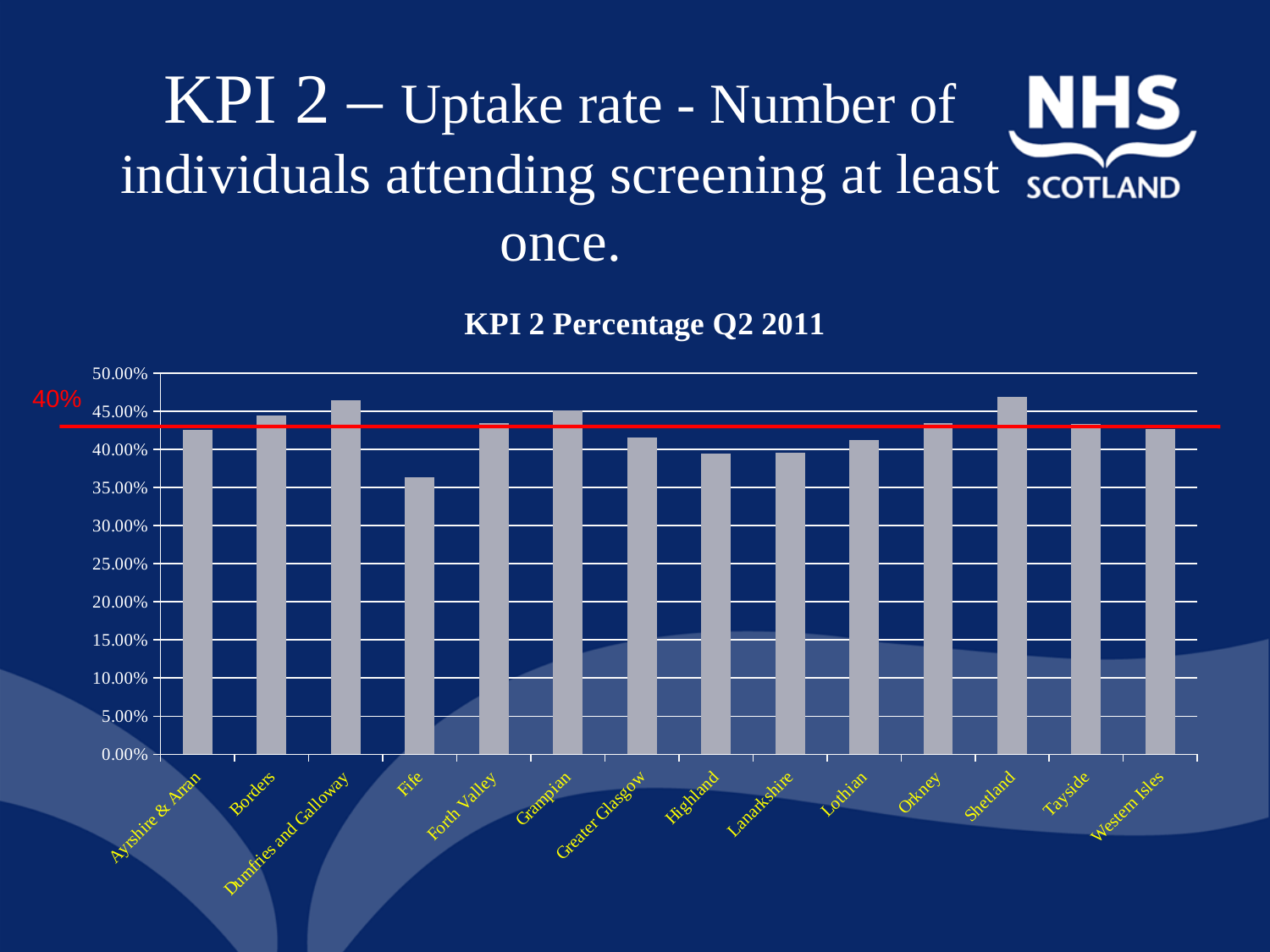
Which is larger, the value for Fife or the value for Shetland? Shetland Is the value for Greater Glasgow greater or less than 40.00%? greater What label is shown in red next to the horizontal red line on the chart? 40% Is the value for Shetland greater or less than 45.00%? greater Is the value for Ayrshire & Arran greater or less than 40.00%? greater How many health boards (categories) are shown on the x axis of the chart? 14 Which is larger, the value for Dumfries and Galloway or the value for Greater Glasgow? Dumfries and Galloway Which health board has the lowest uptake rate in the chart? Fife What is the title of the chart? KPI 2 Percentage Q2 2011 What type of chart is shown on the slide? bar chart